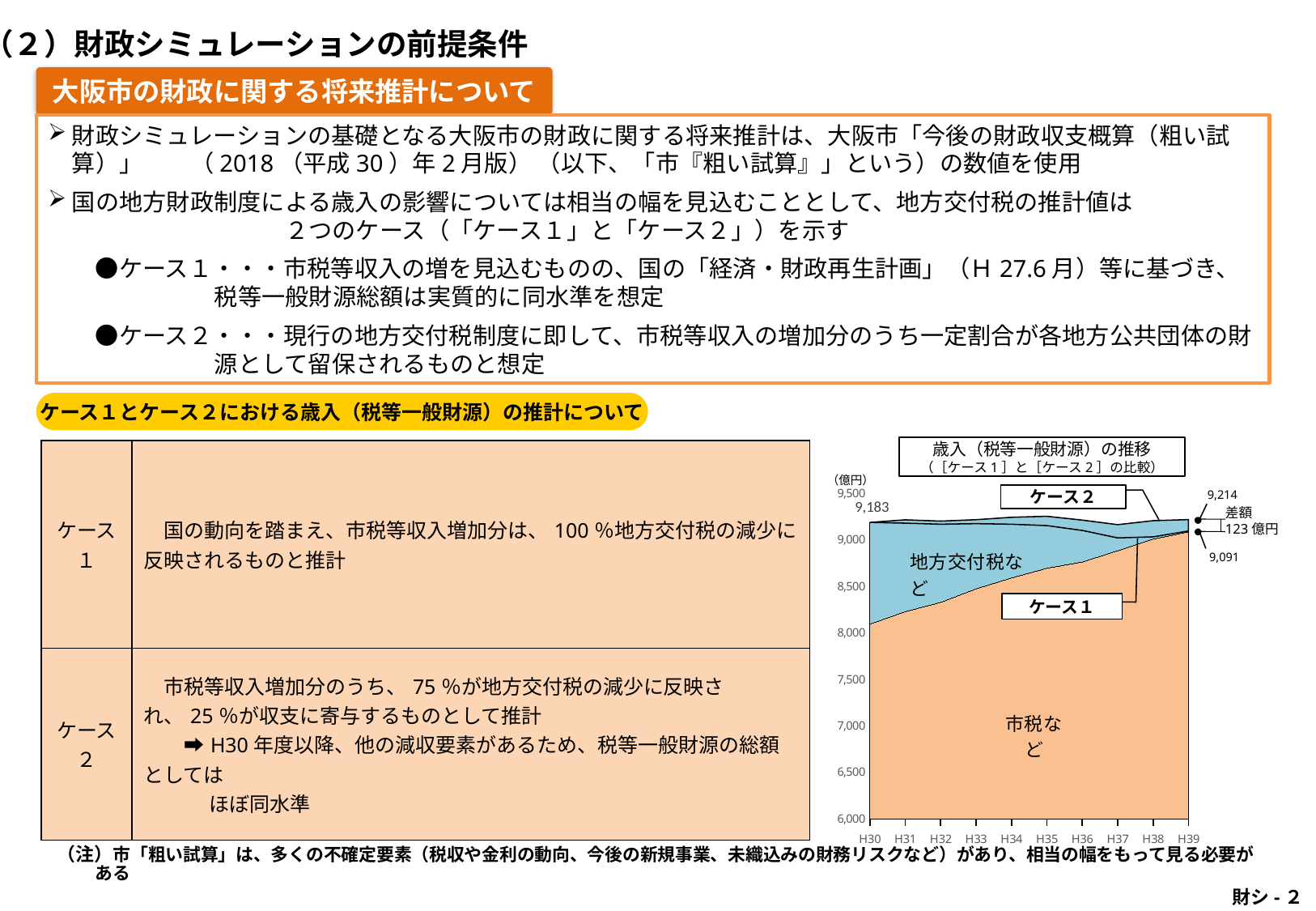
At H39, which is larger, ケース1 or ケース2? ケース2 Does the 市税など area rise or fall from H30 to H39? rise What unit is shown on the y axis of the chart? 億円 How many fiscal years are shown on the x axis of the chart? 10 What kind of chart is shown on the slide? area chart Is the value of 市税など at H30 greater or less than 8,500? less What is the value of 歳入（税等一般財源） at H30 in the chart? 9,183 Is the value of 市税など at H39 greater or less than 8,500? greater What is the difference (差額) between ケース2 and ケース1 at H39? 123 億円 What is the value for ケース2 at H39 in the chart? 9,214 What are the two areas labelled in the chart? 地方交付税など and 市税など What is the value for ケース1 at H39 in the chart? 9,091